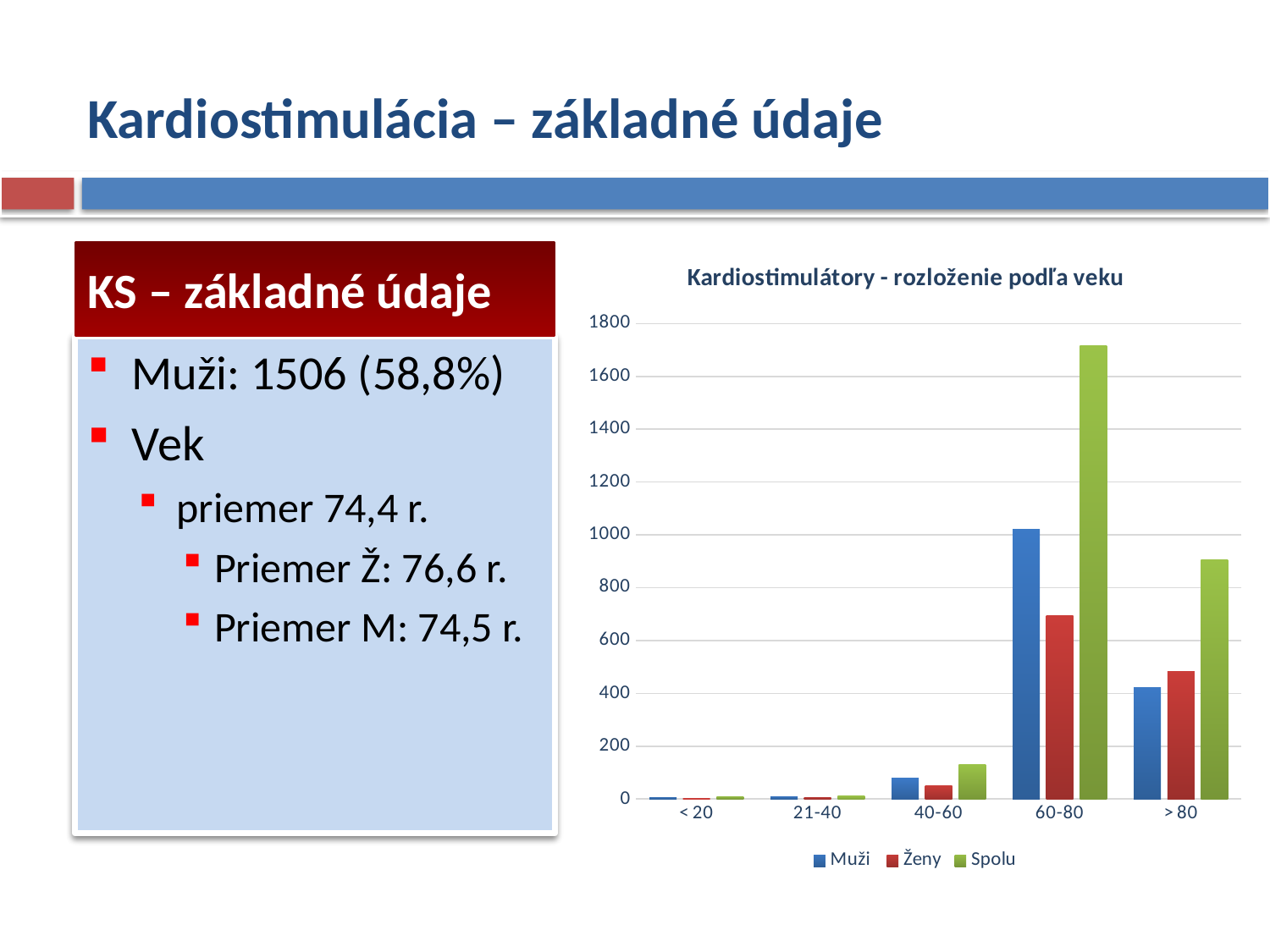
How many series does the legend of the chart list? 3 What is the title of the chart? Kardiostimulátory - rozloženie podľa veku Which is larger for Spolu: the 60-80 category or the > 80 category? 60-80 Is the value for Spolu in the 60-80 category greater or less than 1600? greater Is the value for Muži in the 60-80 category greater or less than 800? greater What kind of chart is shown on the slide? bar chart How many age categories are shown on the x axis of the chart? 5 Which age category has the highest value for Muži? 60-80 Does the value for Spolu rise or fall from the 40-60 category to the 60-80 category? rise Is the value for Spolu in the > 80 category greater or less than 1000? less Which age category has the highest value for Spolu? 60-80